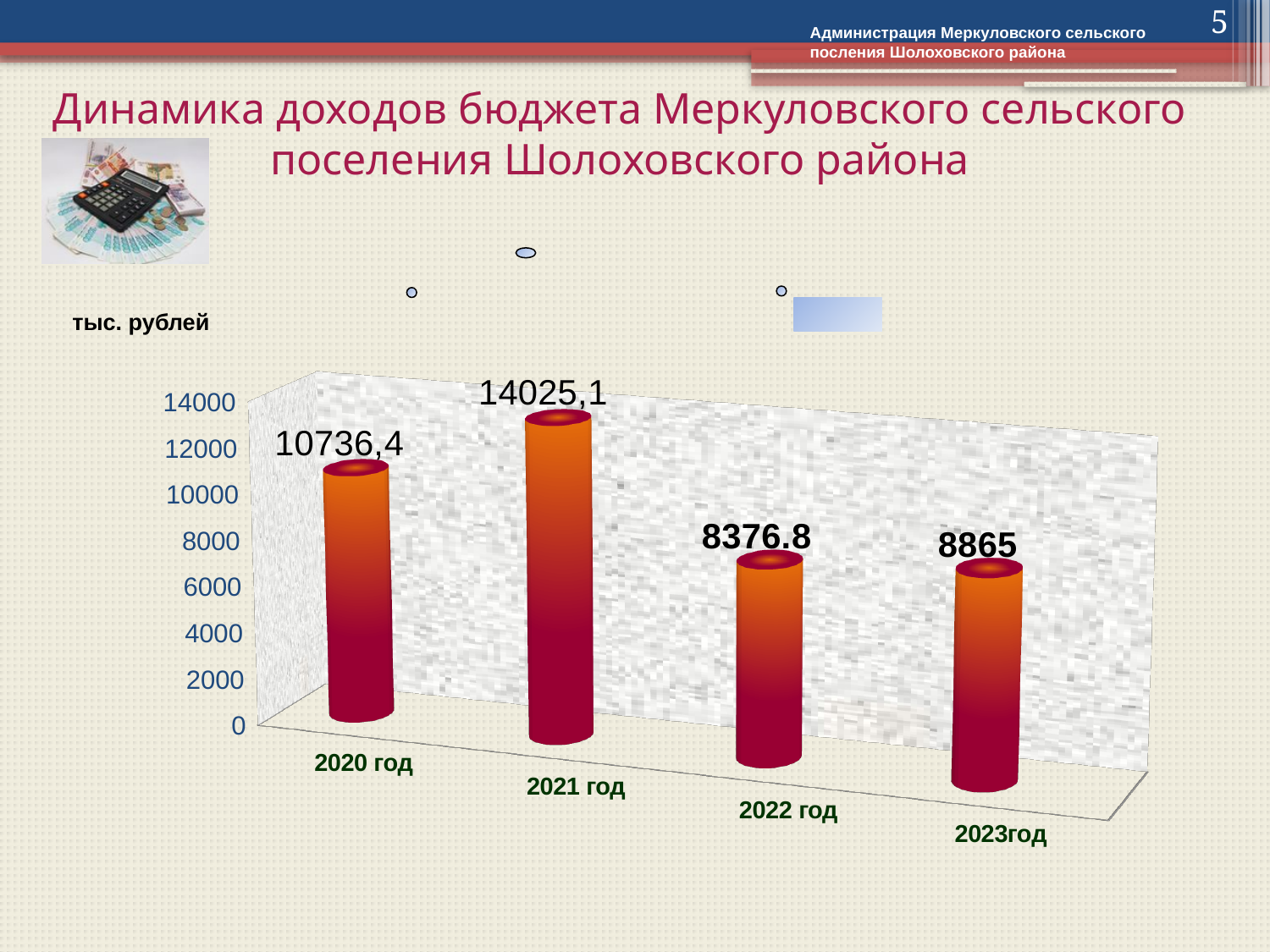
What kind of chart is shown on the slide? bar chart Which is larger, the value for 2020 год or the value for 2023год? 2020 год Is the value for 2023год greater or less than 8000? greater By how much does the 2021 год value exceed the 2020 год value? 3288,7 Which year has the lowest budget revenue on the chart? 2022 год In what units are the chart values given, according to the label above the chart? тыс. рублей What is the budget revenue value shown for 2020 год? 10736,4 What is the budget revenue value shown for 2022 год? 8376.8 How many years are shown on the chart? 4 Which year has the highest budget revenue on the chart? 2021 год What is the budget revenue value shown for 2021 год? 14025,1 What is the budget revenue value shown for 2023год? 8865